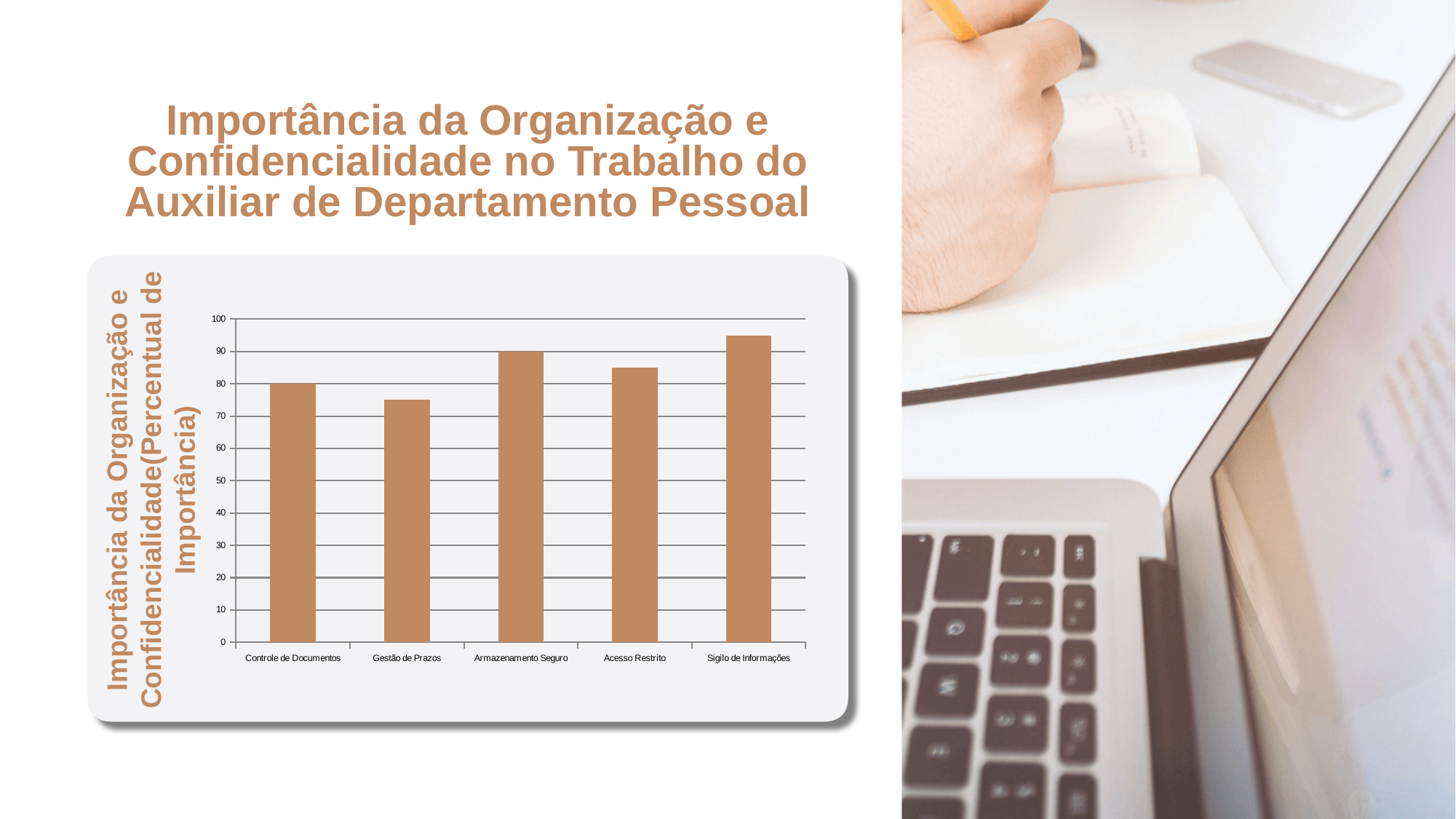
Is the value for Sigilo de Informações greater or less than 90? greater Is the value for Gestão de Prazos greater or less than 80? less What is the value for Armazenamento Seguro? 90 What is the value for Controle de Documentos? 80 Which is larger, the value for Armazenamento Seguro or the value for Acesso Restrito? Armazenamento Seguro Which category has the lowest bar in the chart? Gestão de Prazos Which category has the highest bar in the chart? Sigilo de Informações What is the label on the vertical axis of the chart? Importância da Organização e Confidencialidade(Percentual de Importância) What type of chart is shown on the slide? bar chart Is the value for Acesso Restrito greater or less than 80? greater What is the difference between the values for Armazenamento Seguro and Controle de Documentos? 10 How many categories are shown on the x axis of the chart? 5